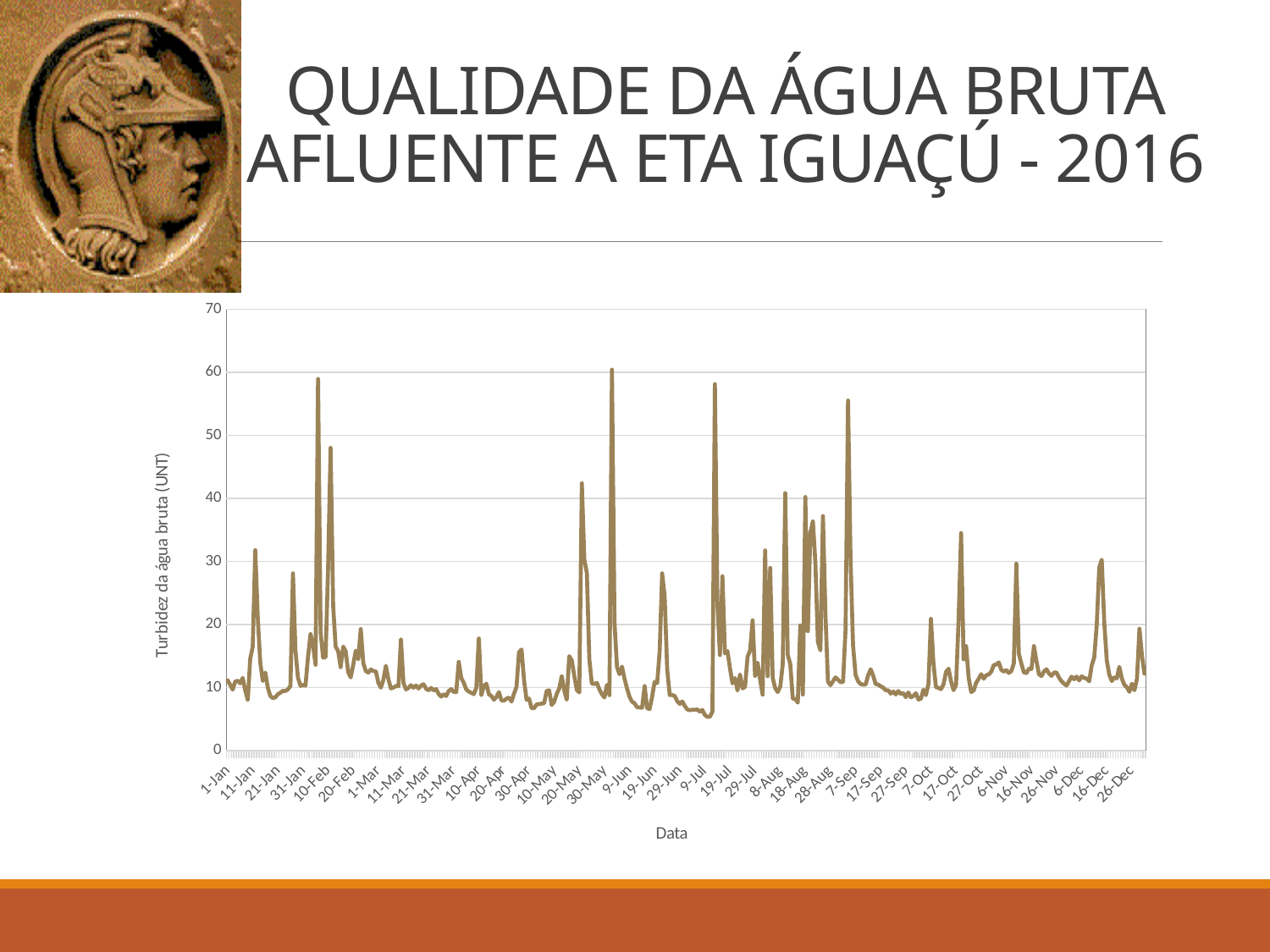
Is the peak value near 7-Sep greater or less than 40? greater What kind of chart is shown on the slide? line chart What is the title of the chart's horizontal axis? Data Is the value around 29-Jun to 9-Jul (between the peaks) greater or less than 10? less Does the turbidity line ever exceed 70 UNT? No Which peak is larger, the one near 9-Jun or the one near 16-Dec? 9-Jun What is the title of the chart's vertical axis? Turbidez da água bruta (UNT) Which peak is larger, the one near 11-Jan or the one near 10-Feb? 10-Feb